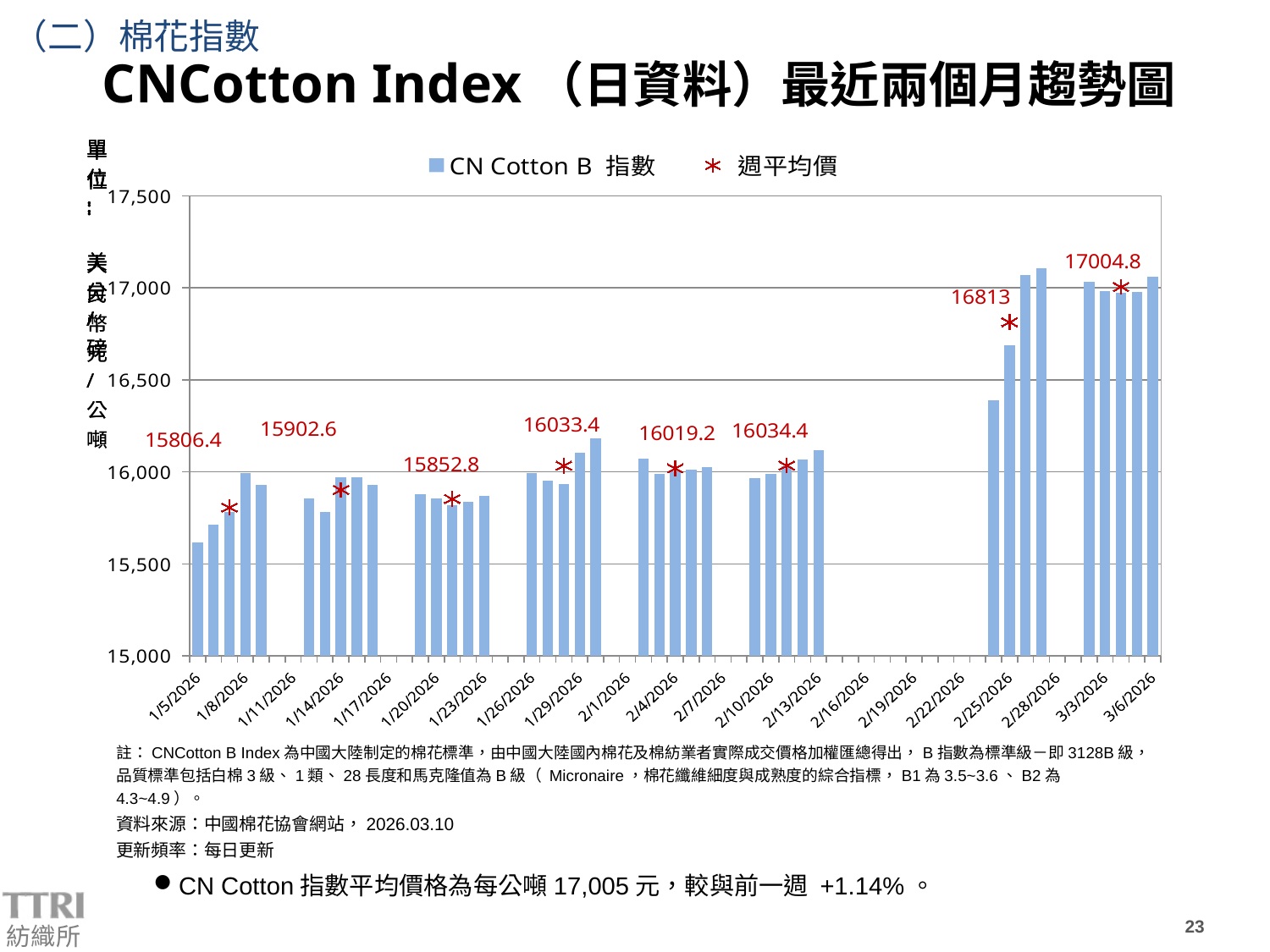
Which labelled weekly average price is the lowest? 15806.4 Which is larger: the weekly average labelled 16033.4 (around 1/29/2026) or the one labelled 16019.2 (around 2/4/2026)? 16033.4 Which labelled weekly average price is the highest? 17004.8 How many weekly average price markers (週平均價) are plotted on the chart? 8 What is the weekly average price labelled for the week around 2/25/2026? 16813 What is the weekly average price labelled for the final week shown (around 3/3/2026)? 17004.8 How many series does the legend list? 2 What is the weekly average price labelled for the week around 1/14/2026? 15902.6 Do the weekly average prices generally rise or fall from January to March 2026? rise What is the difference between the last two labelled weekly average prices, 17004.8 and 16813? 191.8 What is the weekly average price (週平均價) labelled for the week of 1/8/2026? 15806.4 Is the CN Cotton B index bar for 1/5/2026 greater or less than 16,000? less